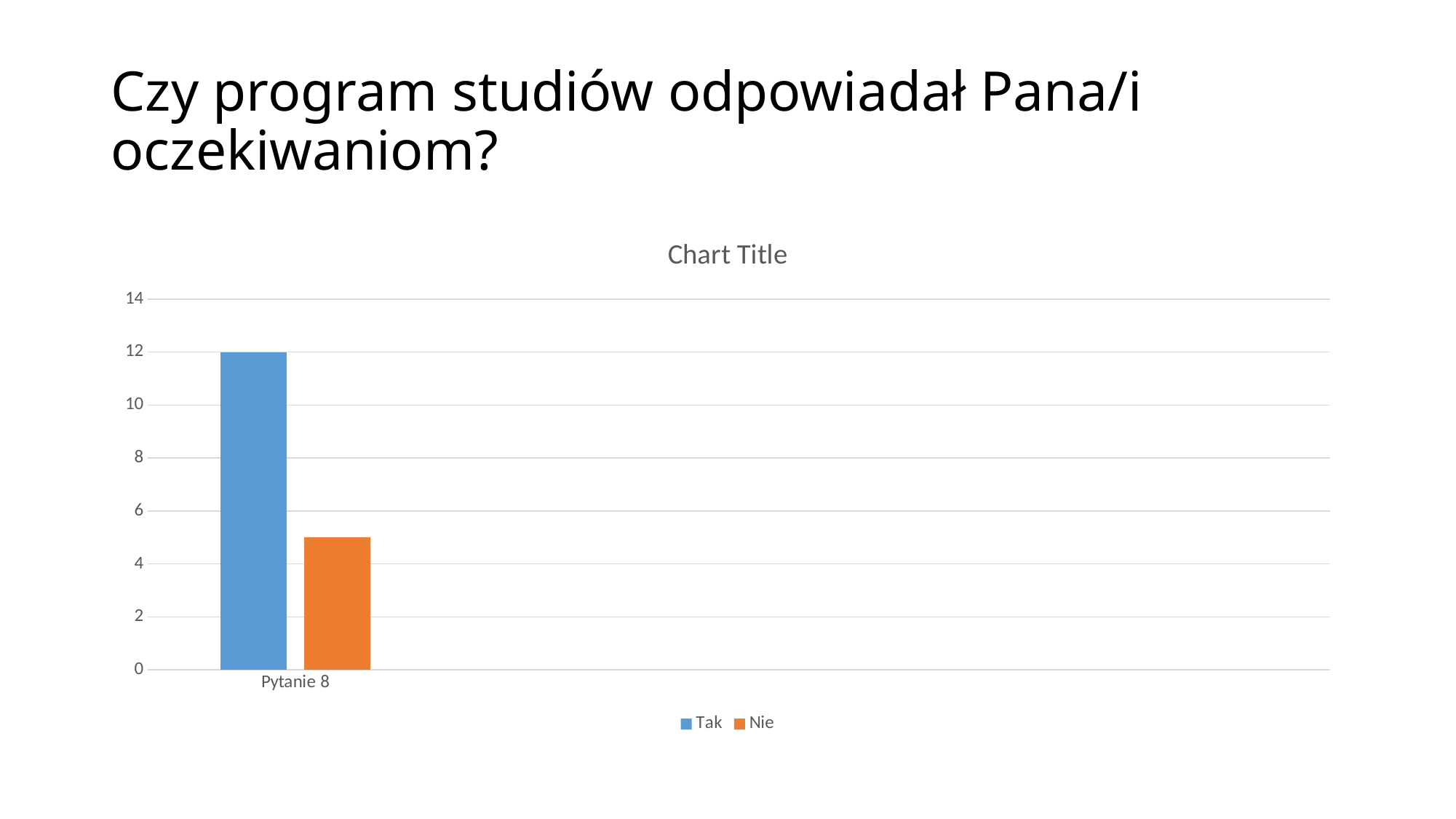
Which series has the lowest bar for Pytanie 8? Nie What is the label of the category on the x axis? Pytanie 8 How many categories are shown on the x axis? 1 Is the value for Nie greater or less than 6? less Which series has the higher value for Pytanie 8, Tak or Nie? Tak Is the value for Tak greater or less than 10? greater What is the value of the Tak bar for Pytanie 8? 12 What colour is the Nie series? orange What kind of chart is shown on the slide? bar chart How many series does the legend list? 2 Is the value for Nie greater or less than 4? greater